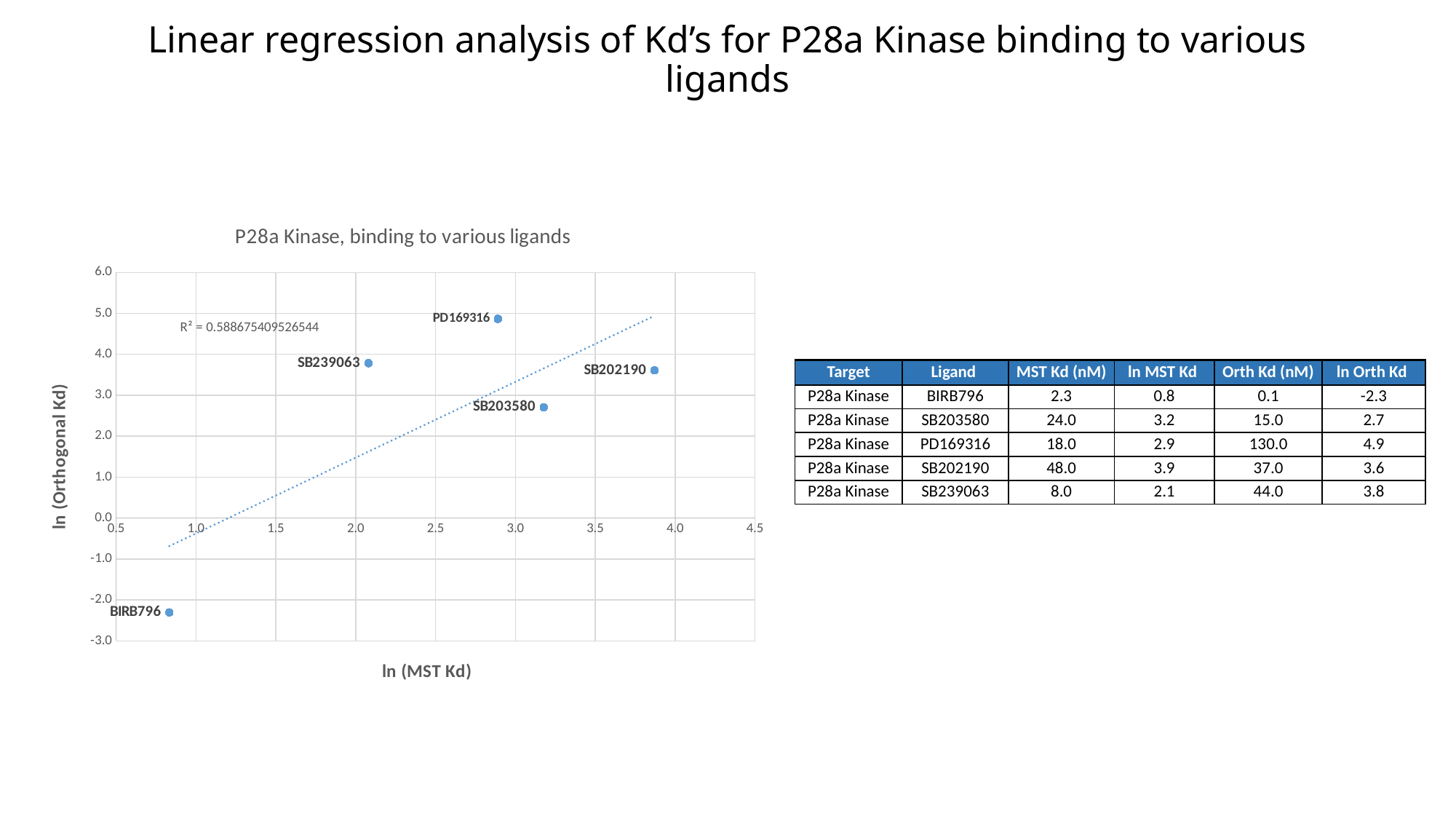
Which ligand has the highest ln (Orthogonal Kd) value in the chart? PD169316 What is the label of the x axis of the chart? ln (MST Kd) What R² value is shown on the chart? 0.588675409526544 Is the ln (Orthogonal Kd) value for SB203580 greater or less than 3.0? less What is the ln MST Kd value for SB239063? 2.1 Is the ln (MST Kd) value for SB202190 greater or less than 3.5? greater Which has the larger ln (Orthogonal Kd) value, PD169316 or SB202190? PD169316 How many data points are plotted in the chart? 5 Which ligand has the lowest ln (Orthogonal Kd) value in the chart? BIRB796 What kind of chart is shown on the slide? scatter chart What is the ln Orth Kd value for BIRB796? -2.3 Is the ln (MST Kd) value for BIRB796 greater or less than 1.0? less